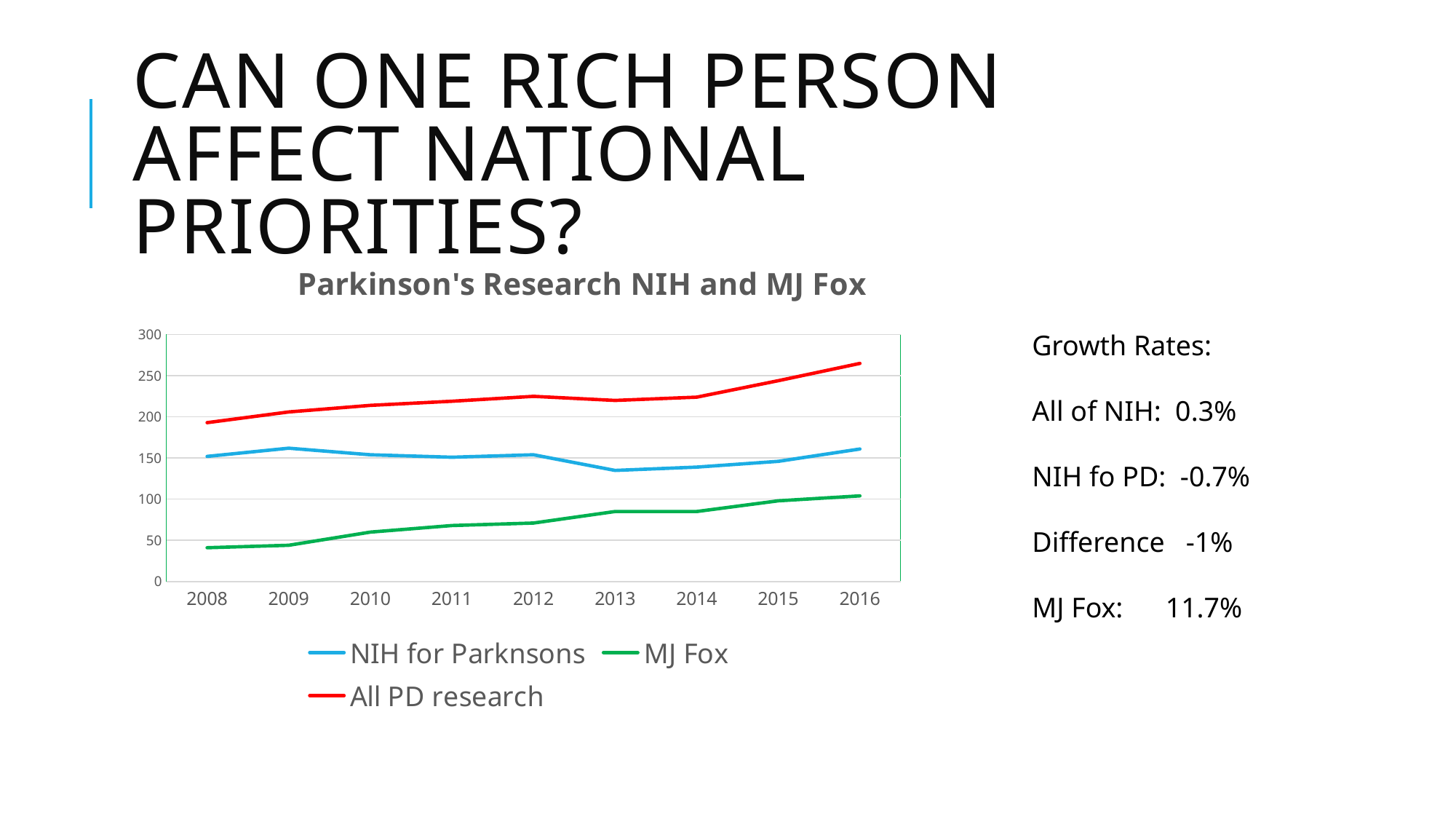
In which year is MJ Fox at its lowest? 2008 What kind of chart is shown on the slide? line chart Is the value for MJ Fox in 2008 greater or less than 50? less Does the MJ Fox line rise or fall from 2008 to 2016? rises How many years are plotted along the x axis of the chart? 9 In which year is All PD research at its highest? 2016 How many series does the legend of the chart list? 3 Is the value for All PD research in 2016 greater or less than 250? greater Is the value for NIH for Parknsons in 2013 greater or less than 150? less In 2016, which is larger: NIH for Parknsons or MJ Fox? NIH for Parknsons Does the All PD research line rise or fall from 2008 to 2016? rises What is the title of the chart? Parkinson's Research NIH and MJ Fox